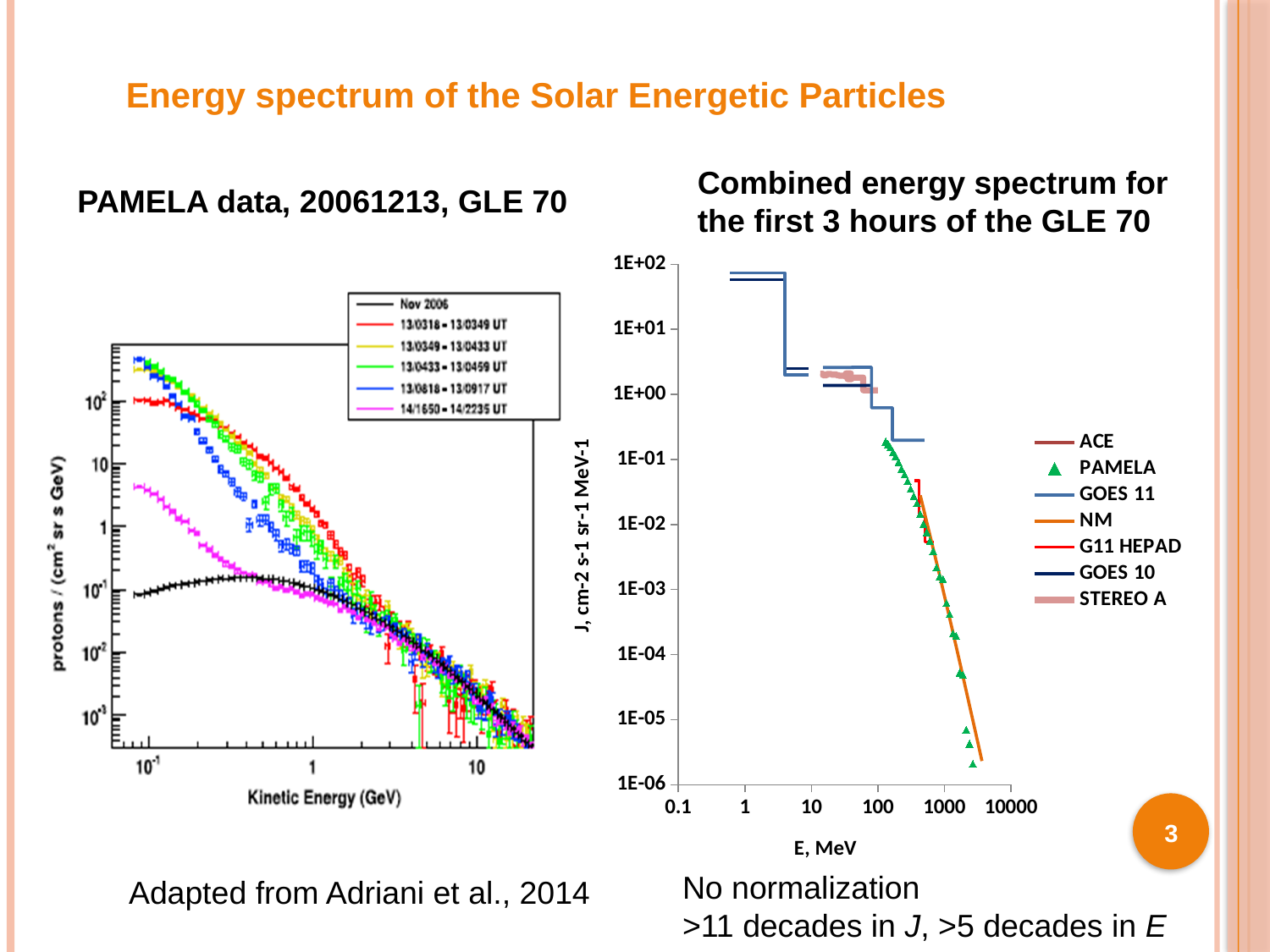
What kind of chart is the right-hand chart 'Combined energy spectrum for the first 3 hours of the GLE 70'? line chart In the right-hand chart 'Combined energy spectrum for the first 3 hours of the GLE 70', is the GOES 11 value at about 1 MeV greater or less than 1E+01? greater Which series in the right-hand chart 'Combined energy spectrum for the first 3 hours of the GLE 70' is drawn with green triangle markers? PAMELA In the right-hand chart 'Combined energy spectrum for the first 3 hours of the GLE 70', is the PAMELA value at about 2000 MeV greater or less than 1E-04? less What is the x-axis label of the right-hand chart 'Combined energy spectrum for the first 3 hours of the GLE 70'? E, MeV In the right-hand chart 'Combined energy spectrum for the first 3 hours of the GLE 70', do the values of J rise or fall as E increases? fall In the left-hand chart 'PAMELA data, 20061213, GLE 70', is the value of the 14/1650 - 14/2235 UT series at 0.1 GeV greater or less than 1 proton / (cm² sr s GeV)? greater In the left-hand chart 'PAMELA data, 20061213, GLE 70', which series has the lowest value at a kinetic energy of 0.1 GeV? Nov 2006 In the left-hand chart 'PAMELA data, 20061213, GLE 70', at a kinetic energy of 0.1 GeV, which is larger: the 13/0318 - 13/0349 UT series or the 14/1650 - 14/2235 UT series? 13/0318 - 13/0349 UT In the left-hand chart 'PAMELA data, 20061213, GLE 70', do the values of the 13/0318 - 13/0349 UT series rise or fall as kinetic energy increases from 1 GeV to 10 GeV? fall How many series does the legend of the left-hand chart, 'PAMELA data, 20061213, GLE 70', list? 6 How many series does the legend of the right-hand chart, 'Combined energy spectrum for the first 3 hours of the GLE 70', list? 7